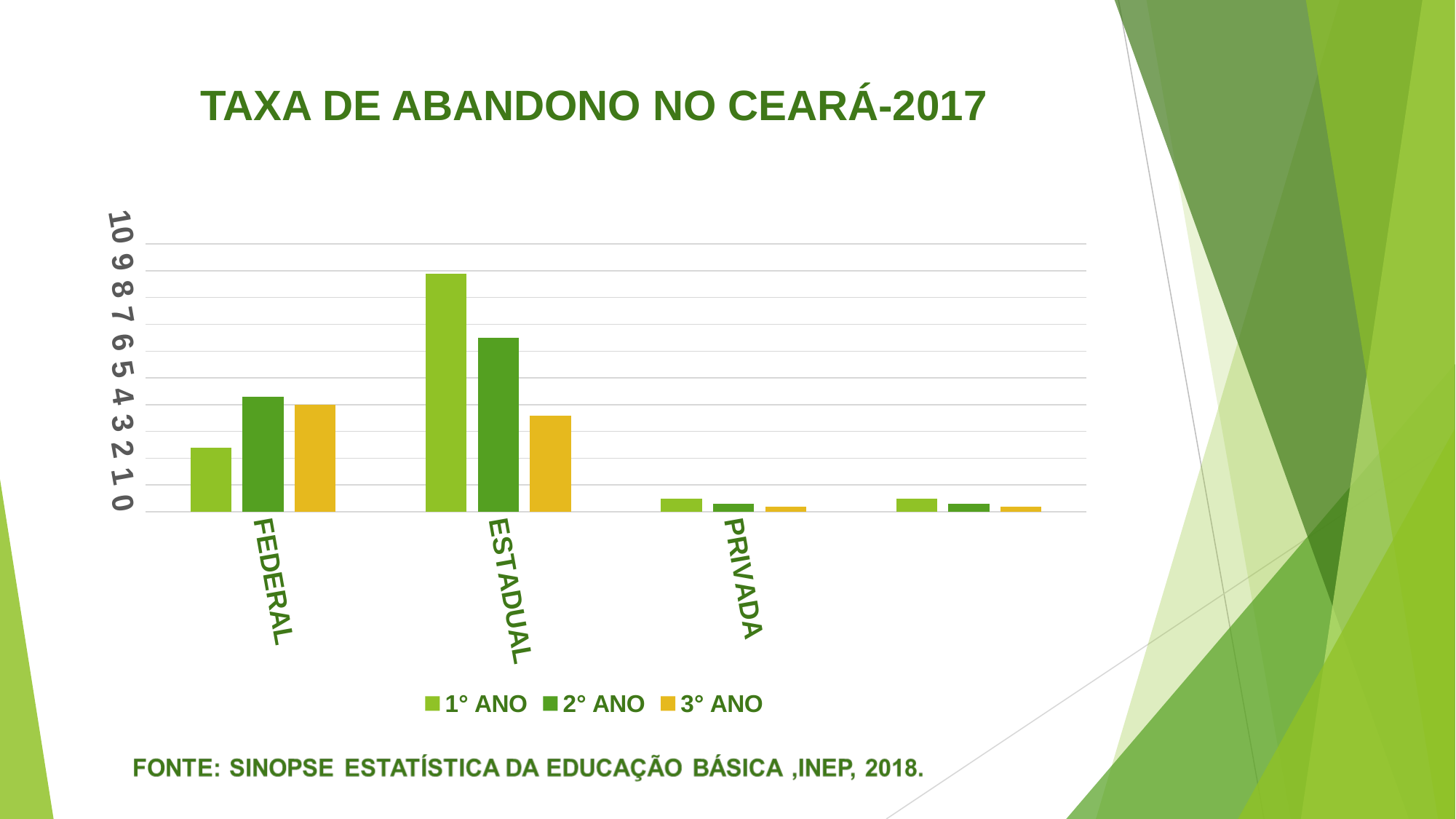
How many series does the legend list? 3 For ESTADUAL, do the values rise or fall from 1° ANO to 3° ANO? fall What is the title of the chart? TAXA DE ABANDONO NO CEARÁ-2017 Is the 3° ANO value for ESTADUAL greater or less than 4? less For ESTADUAL, which series has the lowest value? 3° ANO What kind of chart is shown on the slide? bar chart For FEDERAL, which is larger: the 1° ANO value or the 2° ANO value? 2° ANO Which category has the highest 1° ANO bar? ESTADUAL Is the 2° ANO value for ESTADUAL greater or less than 5? greater Is the 1° ANO value for ESTADUAL greater or less than 8? greater Which series is shown in yellow in the legend? 3° ANO